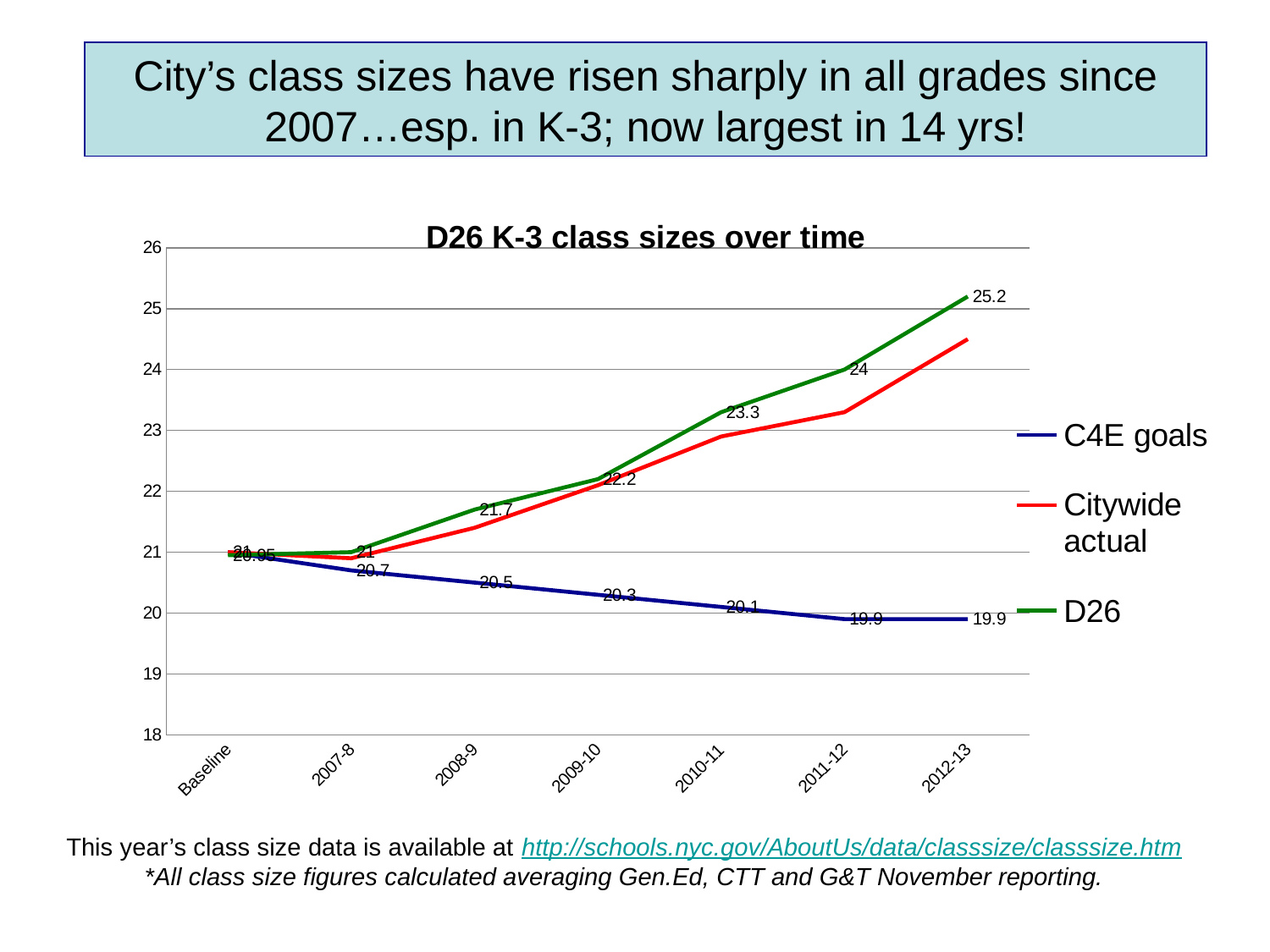
What is the D26 value for 2012-13? 25.2 How many points are plotted along the x axis for each series? 7 What type of chart is shown on the slide? line chart What is the difference between the D26 value and the C4E goals value in 2011-12? 4.1 Does the C4E goals series rise or fall from 2007-8 to 2012-13? fall How many series does the legend list? 3 What is the C4E goals value for 2012-13? 19.9 Is the Citywide actual value for 2012-13 greater or less than 24? greater What is the C4E goals value for 2009-10? 20.3 What is the D26 value for 2010-11? 23.3 In which year does the D26 series reach its highest value? 2012-13 What is the title of the chart? D26 K-3 class sizes over time